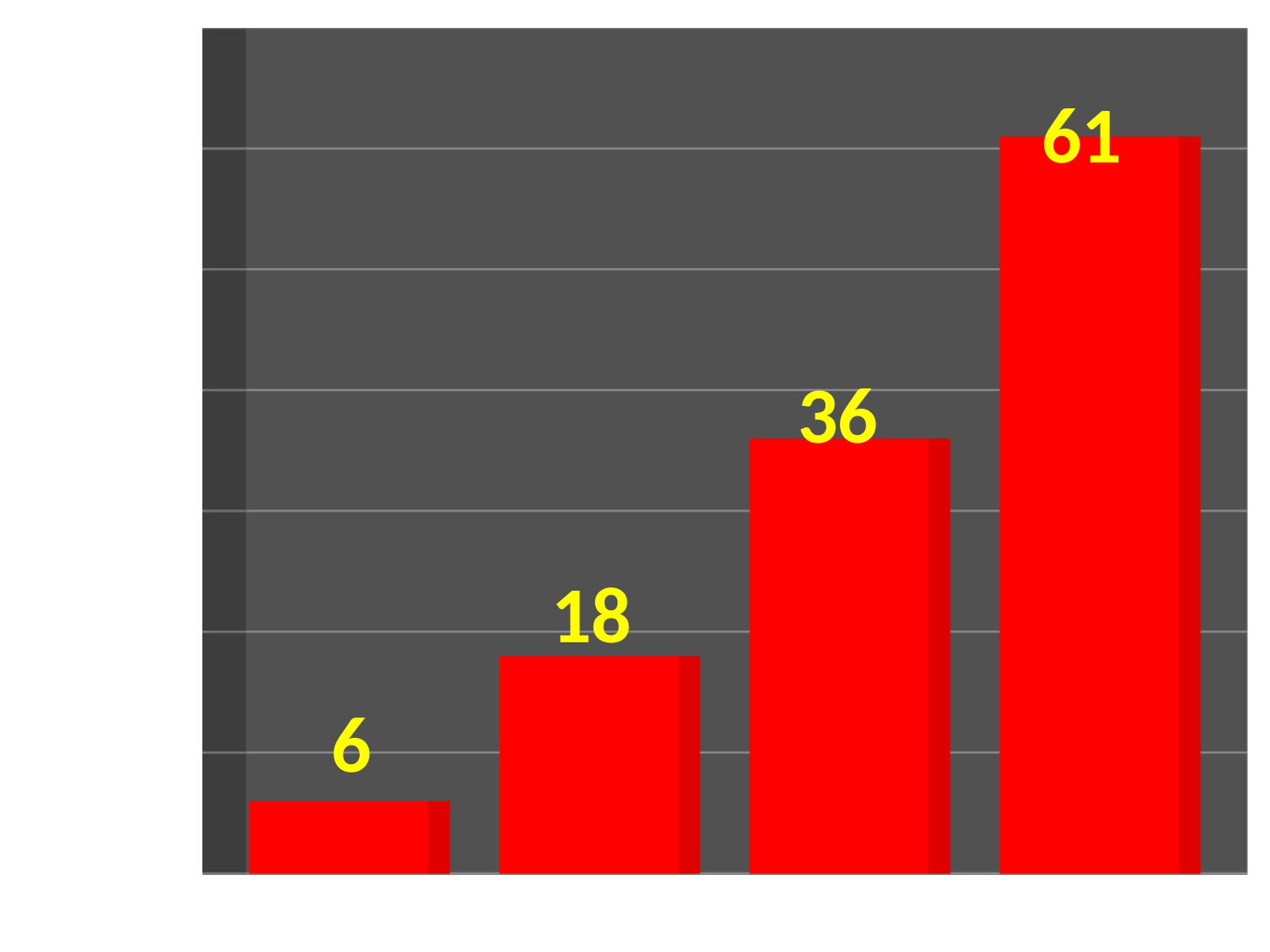
What is the lowest value labelled on any bar in the chart? 6 What is the value shown on the third bar from the left? 36 What kind of chart is shown on the slide? bar chart What is the value shown on the second bar from the left? 18 What is the highest value labelled on any bar in the chart? 61 How many bars are plotted in the chart? 4 What is the difference between the third bar's value and the second bar's value? 18 What is the difference between the rightmost bar's value and the leftmost bar's value? 55 Do the bar values rise or fall from left to right across the chart? rise What is the value shown on the fourth (rightmost) bar? 61 What is the value shown on the first (leftmost) bar? 6 Which is larger, the value of the second bar or the value of the third bar? the third bar